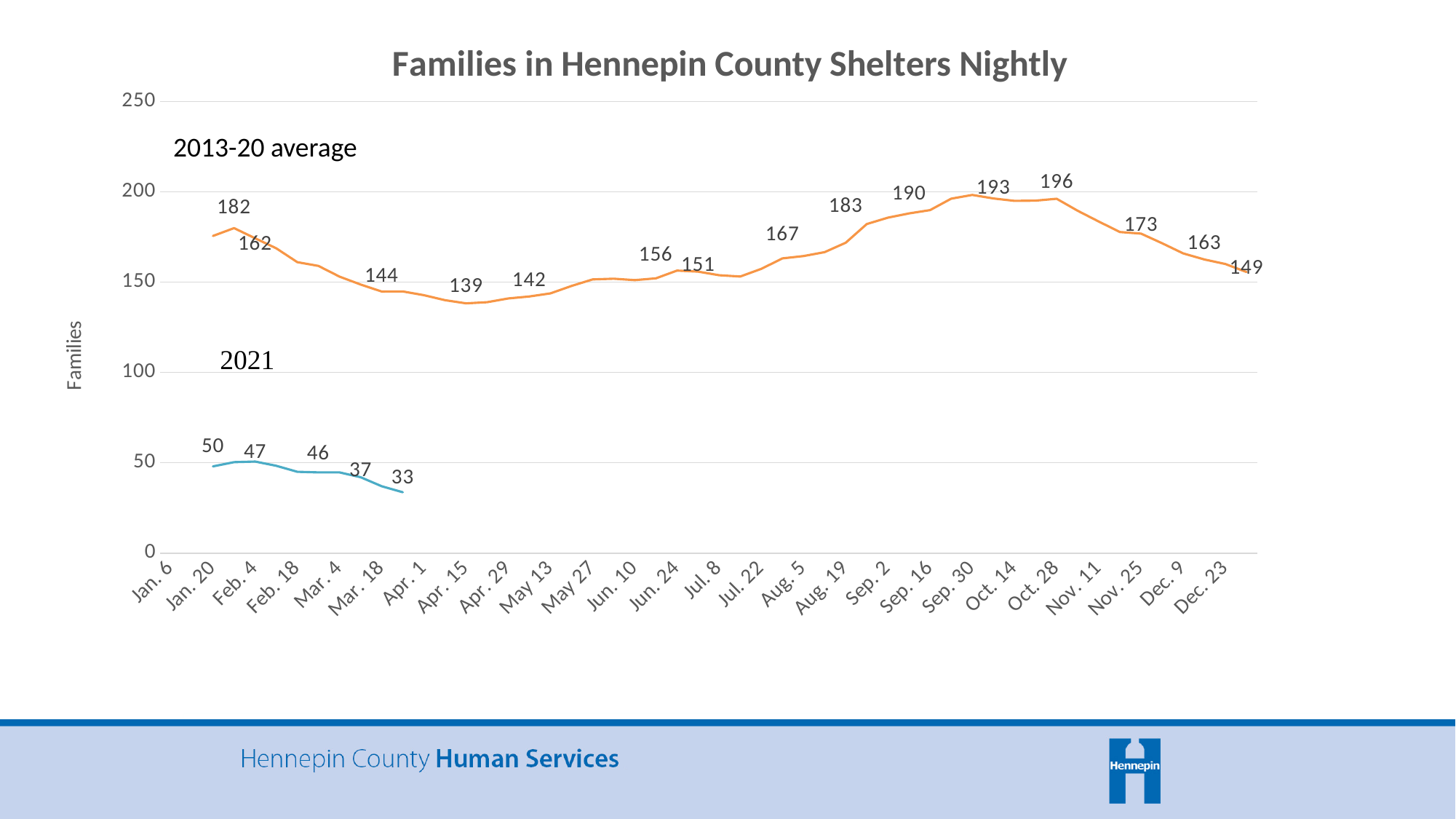
What kind of chart is shown on the slide? line chart What is the highest labelled value on the 2013-20 average line? 196 Which series has higher values, 2013-20 average or 2021? 2013-20 average How many series are plotted on the chart? 2 What is the label on the vertical axis of the chart? Families What is the difference between the highest and lowest labelled values on the 2013-20 average line? 57 Do the values on the 2021 line rise or fall from left to right? fall What is the difference between the highest and lowest labelled values on the 2021 line? 17 What is the lowest labelled value on the 2021 line? 33 What is the highest labelled value on the 2021 line? 50 Is the highest value on the 2021 line greater or less than 100? less What is the lowest labelled value on the 2013-20 average line? 139